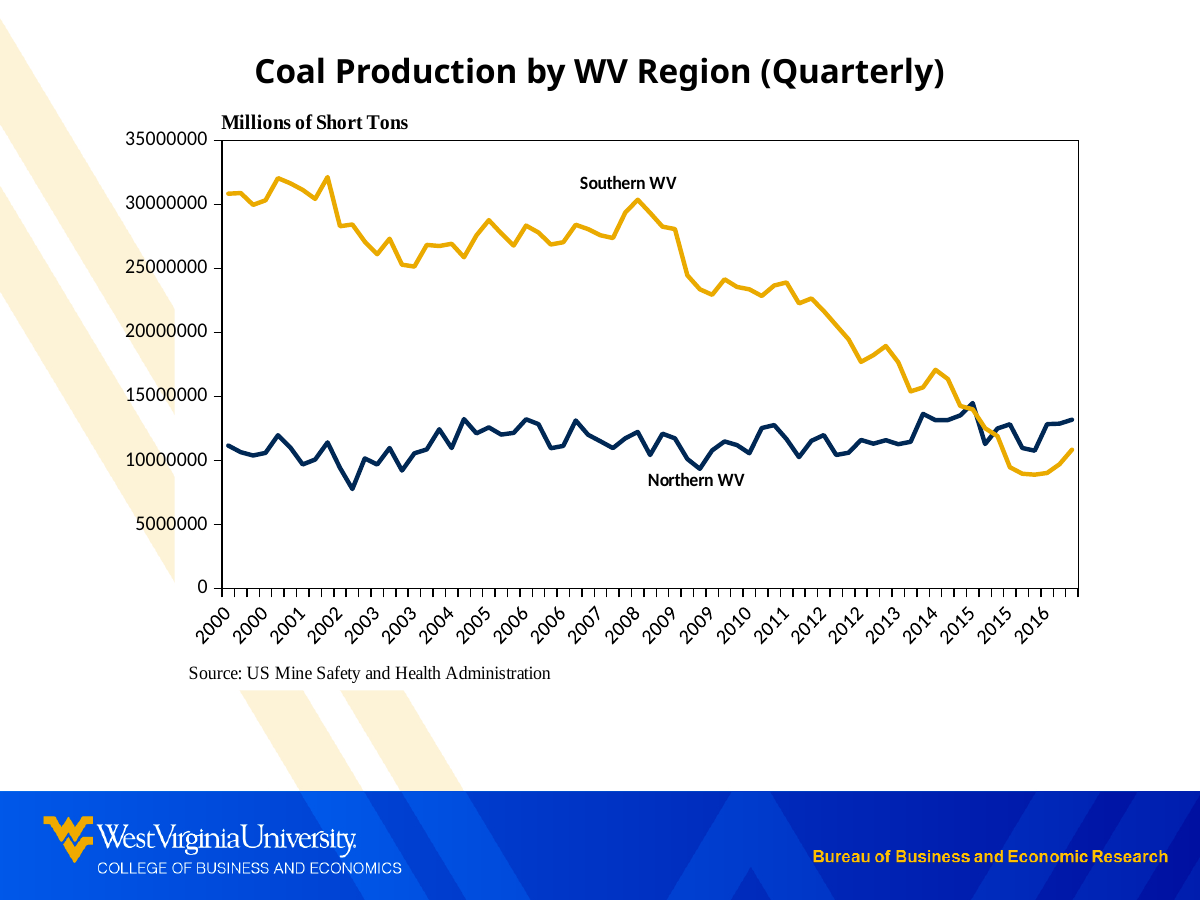
Which series reaches the highest value on the chart? Southern WV What is the title of the chart? Coal Production by WV Region (Quarterly) What are the names of the two series plotted on the chart? Southern WV and Northern WV Is the peak value for Southern WV in 2008 greater or less than 25000000? greater Does the Southern WV series generally rise or fall from 2000 to 2016? Fall How many series are plotted on the chart? 2 Is the lowest value for Northern WV in 2002 greater or less than 10000000? less At the end of 2016, which series has the higher value, Southern WV or Northern WV? Northern WV In 2008, which series has the higher value, Southern WV or Northern WV? Southern WV Is the value for Southern WV at the end of 2016 greater or less than 15000000? less What kind of chart is shown on the slide? Line chart